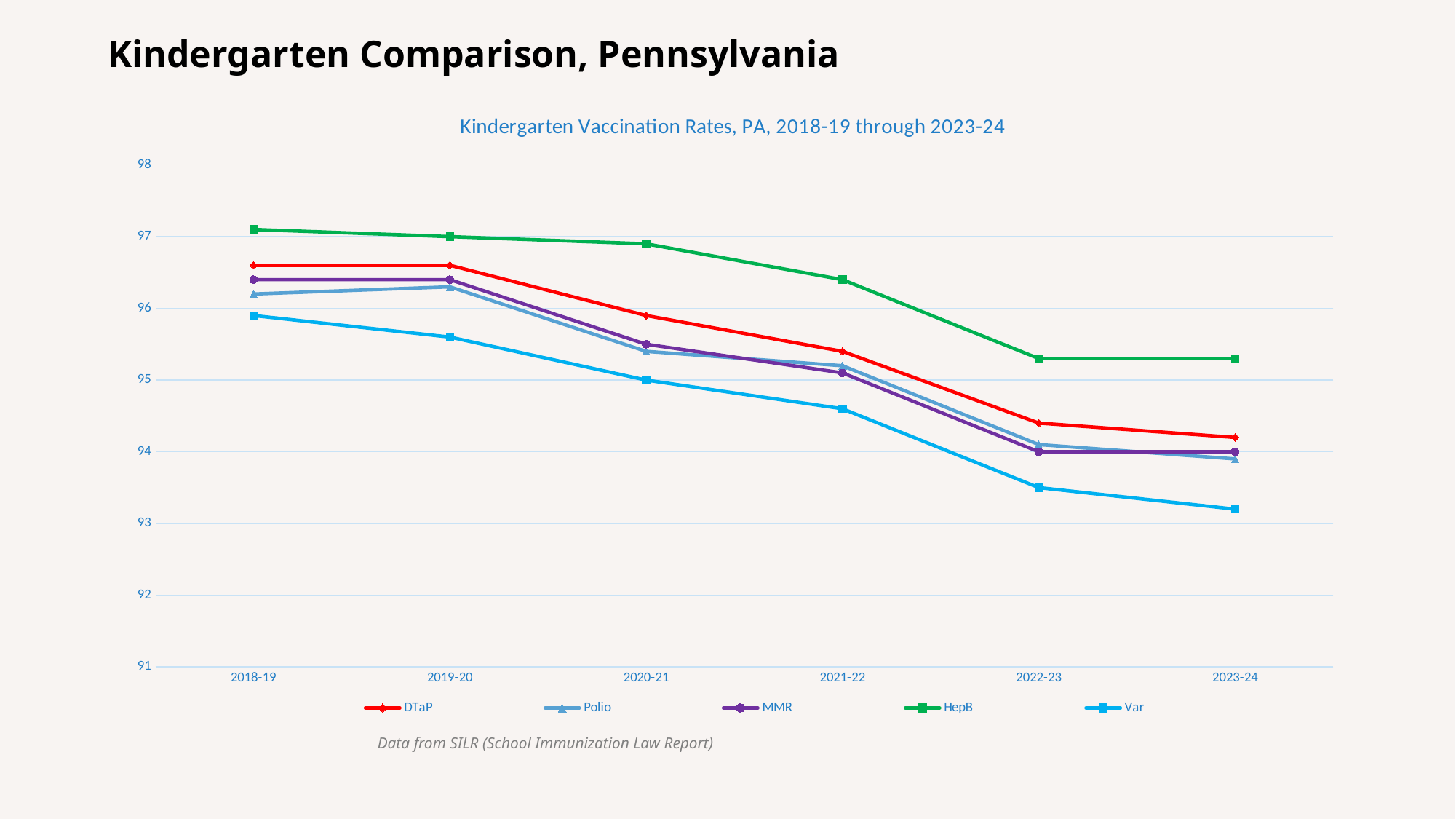
Is the value for Var in 2023-24 greater or less than 93? greater Is the value for Var in 2022-23 greater or less than 94? less Which series has the lowest vaccination rate in 2023-24? Var Which is larger in 2021-22, the value for HepB or the value for Var? HepB Is the value for DTaP in 2023-24 greater or less than 94? greater How many series does the legend list? 5 What kind of chart is shown on the slide? line chart What is the title of the chart? Kindergarten Vaccination Rates, PA, 2018-19 through 2023-24 Which series has the highest vaccination rate in 2023-24? HepB How many school years are plotted along the x axis? 6 Do the vaccination rates rise or fall from 2018-19 to 2023-24? fall